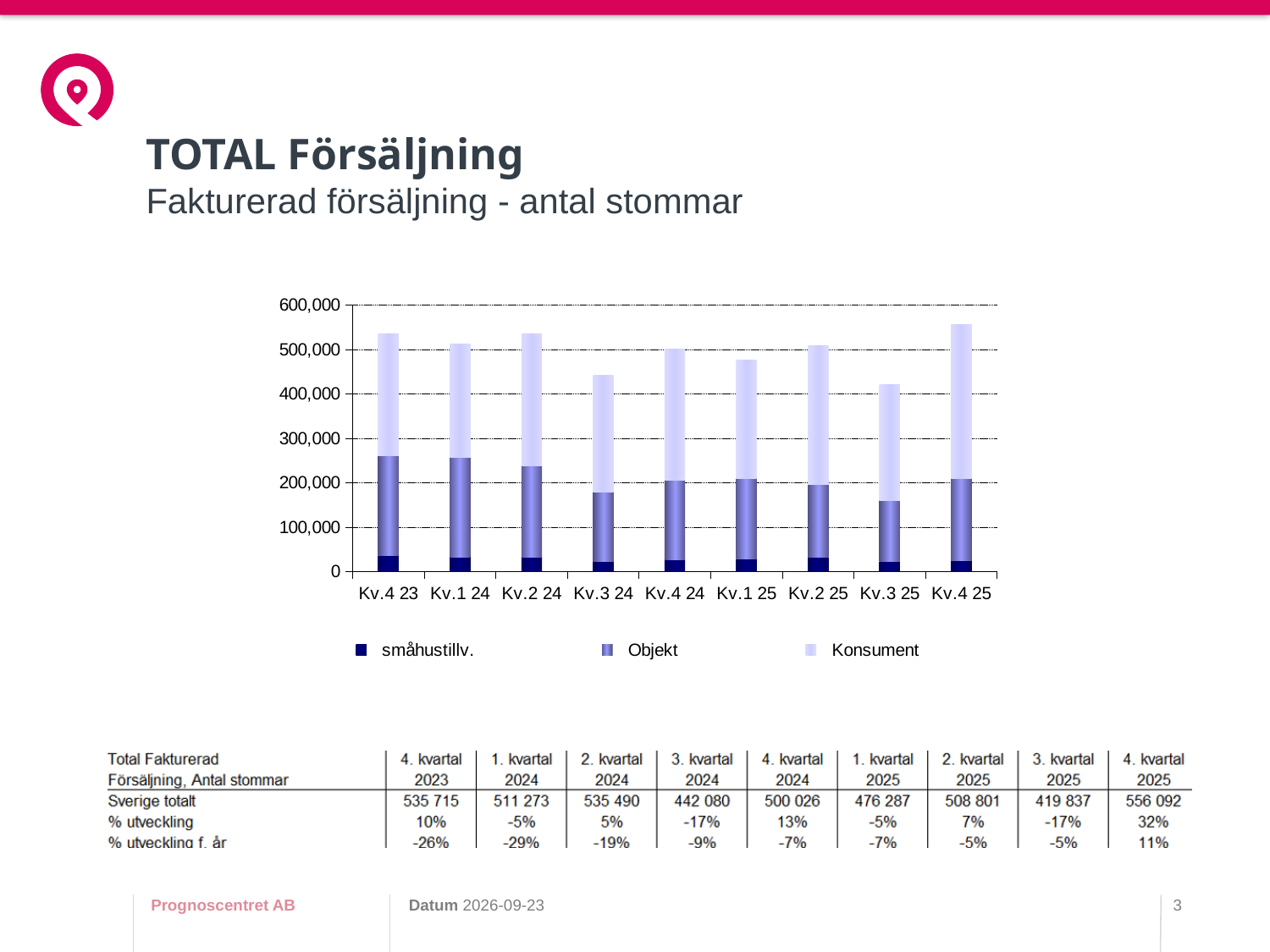
According to the table below the chart, what is the Sverige totalt value for 3. kvartal 2024? 442 080 Which quarter has the lowest total bar in the chart? Kv.3 25 What are the three series named in the chart legend? småhustillv., Objekt, Konsument According to the table below the chart, what is the Sverige totalt value for 4. kvartal 2025? 556 092 How many quarters are shown along the x axis of the chart? 9 Which total bar is taller, Kv.4 23 or Kv.3 24? Kv.4 23 Is the total bar for Kv.4 25 greater or less than 500,000? greater Does the total bar rise or fall from Kv.3 25 to Kv.4 25? rise Is the total bar for Kv.3 24 greater or less than 500,000? less What kind of chart is shown on the slide? Stacked bar chart How many series does the chart legend list? 3 Which quarter has the highest total bar in the chart? Kv.4 25